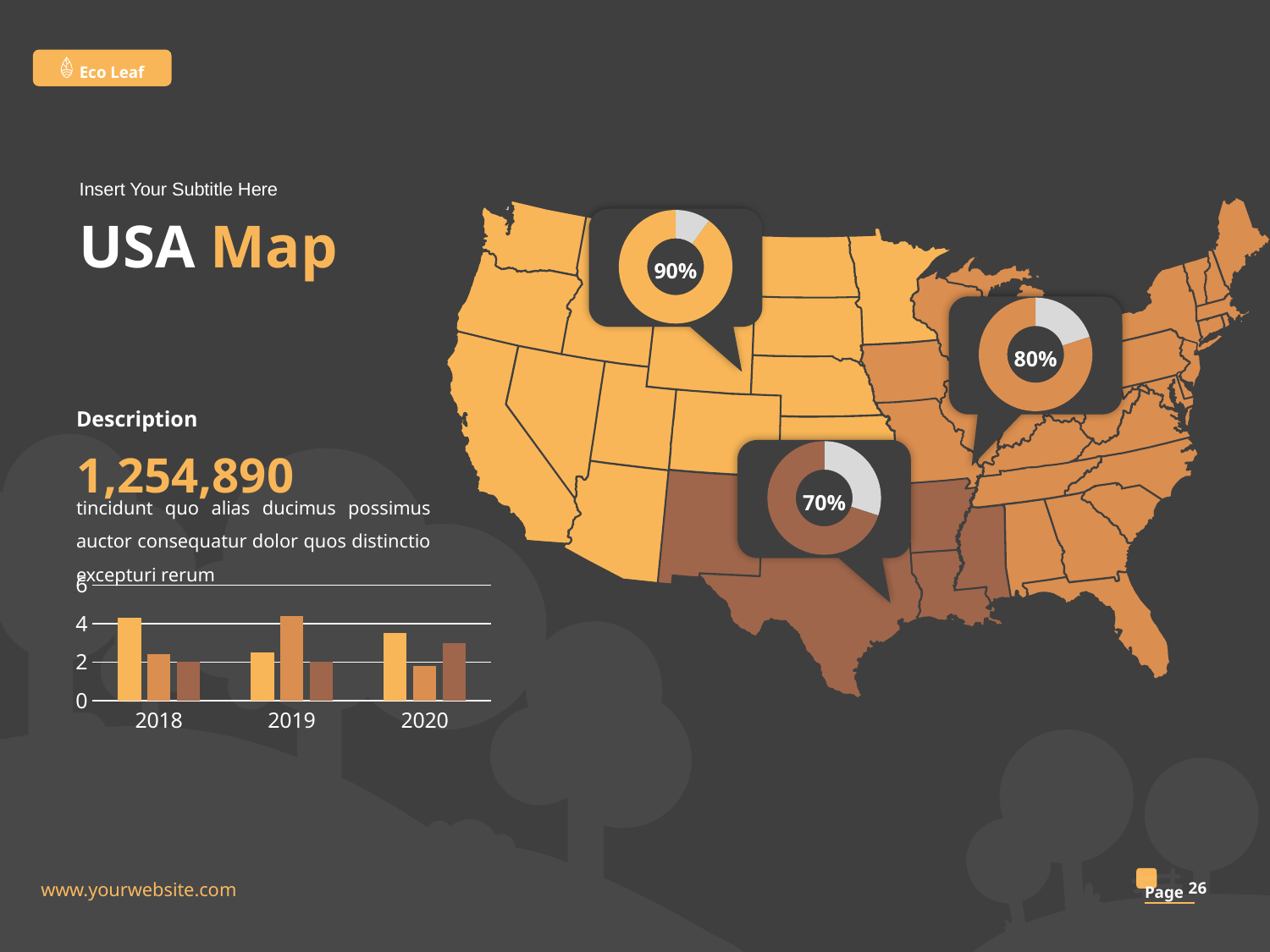
What percentage is shown in the donut chart over the northeastern part of the USA map? 80% What kind of chart is shown at the bottom left of the slide? bar chart In the bar chart at the bottom left, is the value of the first (leftmost) bar for 2018 greater or less than 4? greater In the bar chart at the bottom left, is the value of the middle bar for 2019 greater or less than 4? greater In the bar chart at the bottom left, is the value of the first (leftmost) bar for 2020 greater or less than 4? less What percentage is shown in the donut chart over the northwestern part of the USA map? 90% In the bar chart at the bottom left, which bar is taller for 2018: the first (leftmost) bar or the middle bar? the first (leftmost) bar How many categories are shown on the x axis of the bar chart at the bottom left? 3 Which years are shown on the x axis of the bar chart at the bottom left? 2018, 2019, 2020 What percentage is shown in the donut chart over the southern part of the USA map? 70% In the bar chart at the bottom left, which bar is taller for 2019: the first (leftmost) bar or the middle bar? the middle bar